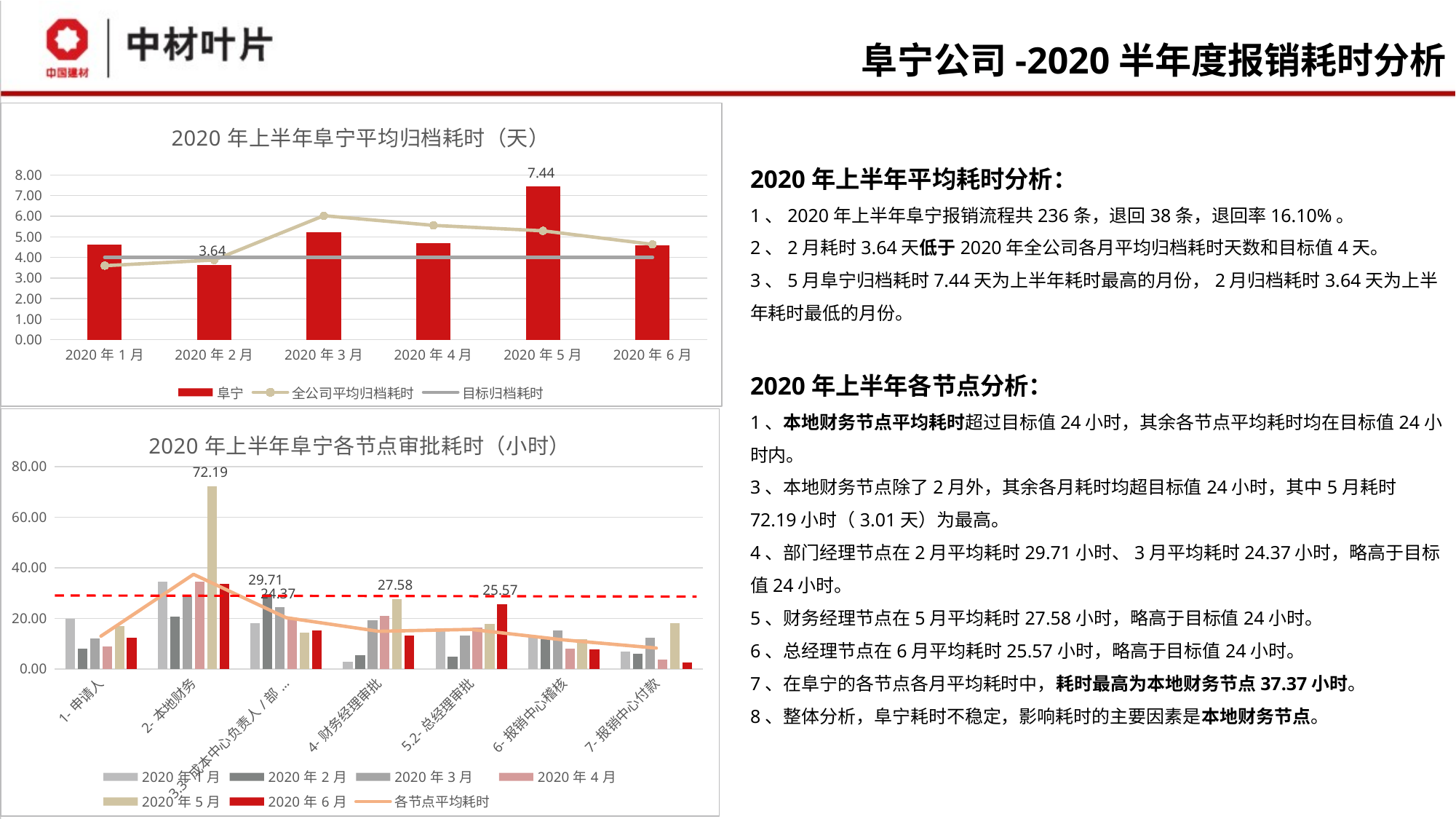
In the top chart (2020年上半年阜宁平均归档耗时（天）), which month has the lowest 阜宁 bar? 2020年2月 In the top chart (2020年上半年阜宁平均归档耗时（天）), what is the 阜宁 value for 2020年5月? 7.44 In the top chart (2020年上半年阜宁平均归档耗时（天）), how many series does the legend list? 3 In the top chart (2020年上半年阜宁平均归档耗时（天）), how many months are shown on the x axis? 6 In the top chart (2020年上半年阜宁平均归档耗时（天）), is the 阜宁 value for 2020年1月 greater or less than 4.00? greater In the bottom chart (2020年上半年阜宁各节点审批耗时（小时）), how many series does the legend list? 7 In the bottom chart (2020年上半年阜宁各节点审批耗时（小时）), how many node categories are shown on the x axis? 7 In the top chart (2020年上半年阜宁平均归档耗时（天）), which month has the highest 阜宁 bar? 2020年5月 In the bottom chart (2020年上半年阜宁各节点审批耗时（小时）), what is the 2020年5月 value for 2-本地财务? 72.19 In the top chart (2020年上半年阜宁平均归档耗时（天）), what is the difference between the 阜宁 values for 2020年5月 and 2020年2月? 3.80 In the bottom chart (2020年上半年阜宁各节点审批耗时（小时）), what is the 2020年6月 value for 5.2-总经理审批? 25.57 In the top chart (2020年上半年阜宁平均归档耗时（天）), what is the 阜宁 value for 2020年2月? 3.64